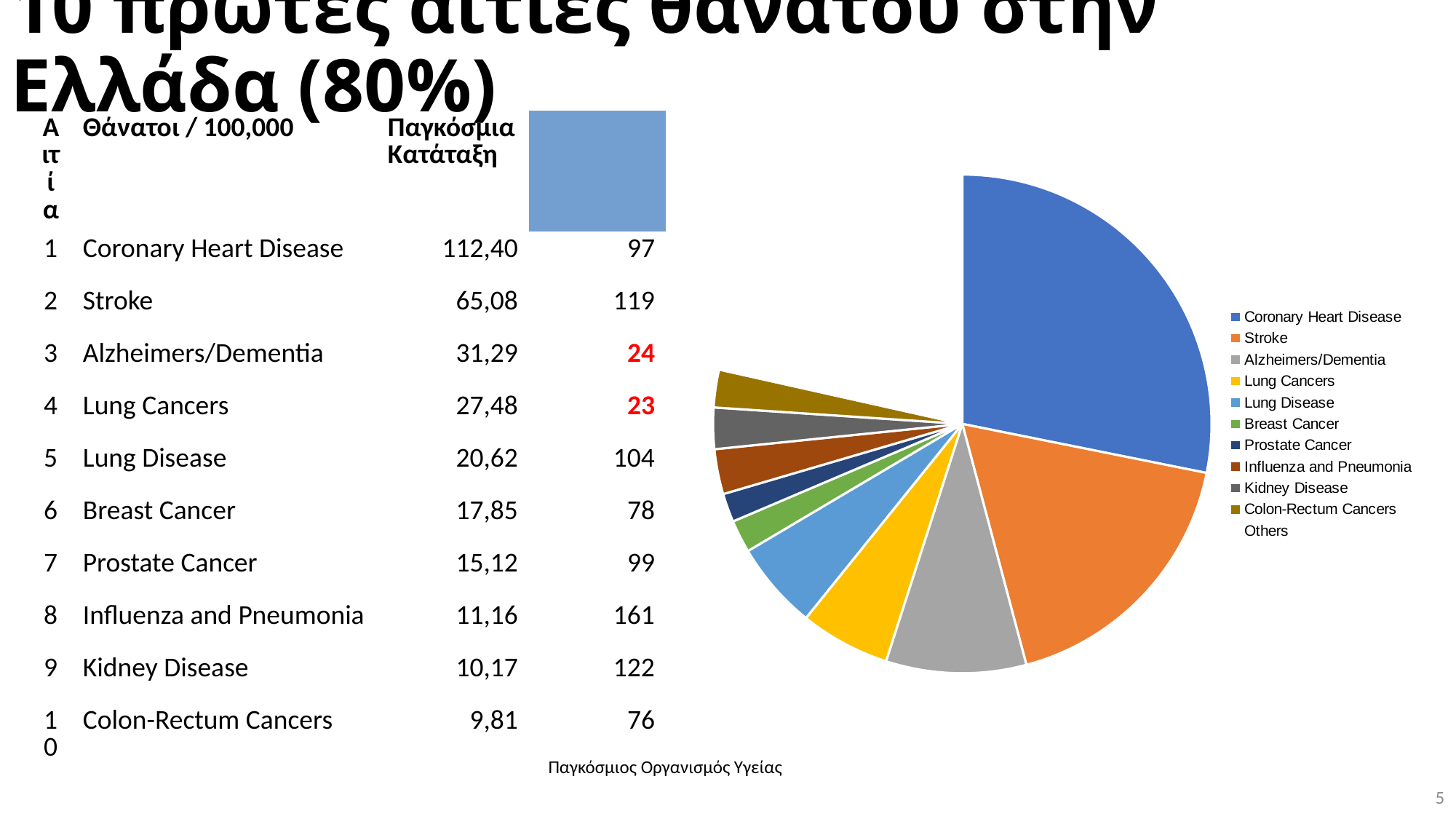
In the pie chart, which slice is larger: Alzheimers/Dementia or Kidney Disease? Alzheimers/Dementia What colour is the Coronary Heart Disease slice in the pie chart? blue How many categories does the pie chart's legend list? 11 What is the last entry listed in the pie chart's legend? Others In the pie chart, which slice is larger: Lung Cancers or Breast Cancer? Lung Cancers Which category has the largest slice in the pie chart? Coronary Heart Disease According to the table on the slide, what is the deaths per 100,000 value for Coronary Heart Disease? 112,40 In the pie chart, which slice is larger: Stroke or Alzheimers/Dementia? Stroke According to the table on the slide, what is the deaths per 100,000 value for Colon-Rectum Cancers? 9,81 According to the table on the slide, what is the deaths per 100,000 value for Stroke? 65,08 What kind of chart is shown on the slide? pie chart